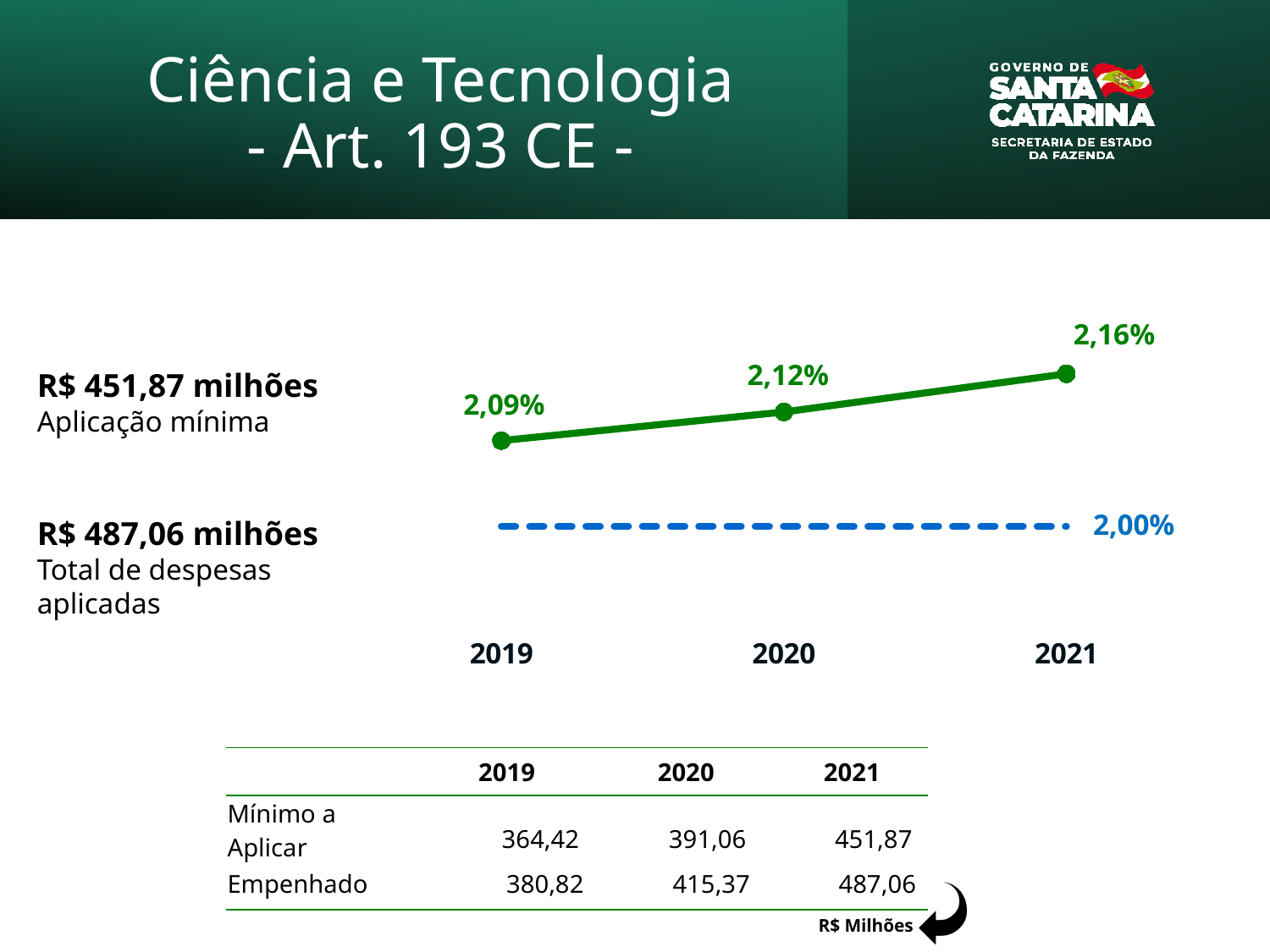
Which year has the lowest value on the green line? 2019 What is the difference between the 2021 and 2019 values on the green line? 0,07% What is the value plotted for 2020 on the green line? 2,12% Do the values on the green line rise or fall from 2019 to 2021? rise How many years are shown on the x axis of the chart? 3 Is the value for 2019 on the green line greater or less than 2,00%? greater Which year has the highest value on the green line? 2021 What is the difference between the 2020 and 2019 values on the green line? 0,03% What kind of chart is shown on the slide? line chart Which is larger, the value for 2020 or the value for 2021? 2021 What is the value plotted for 2019 on the green line? 2,09% What is the value plotted for 2021 on the green line? 2,16%